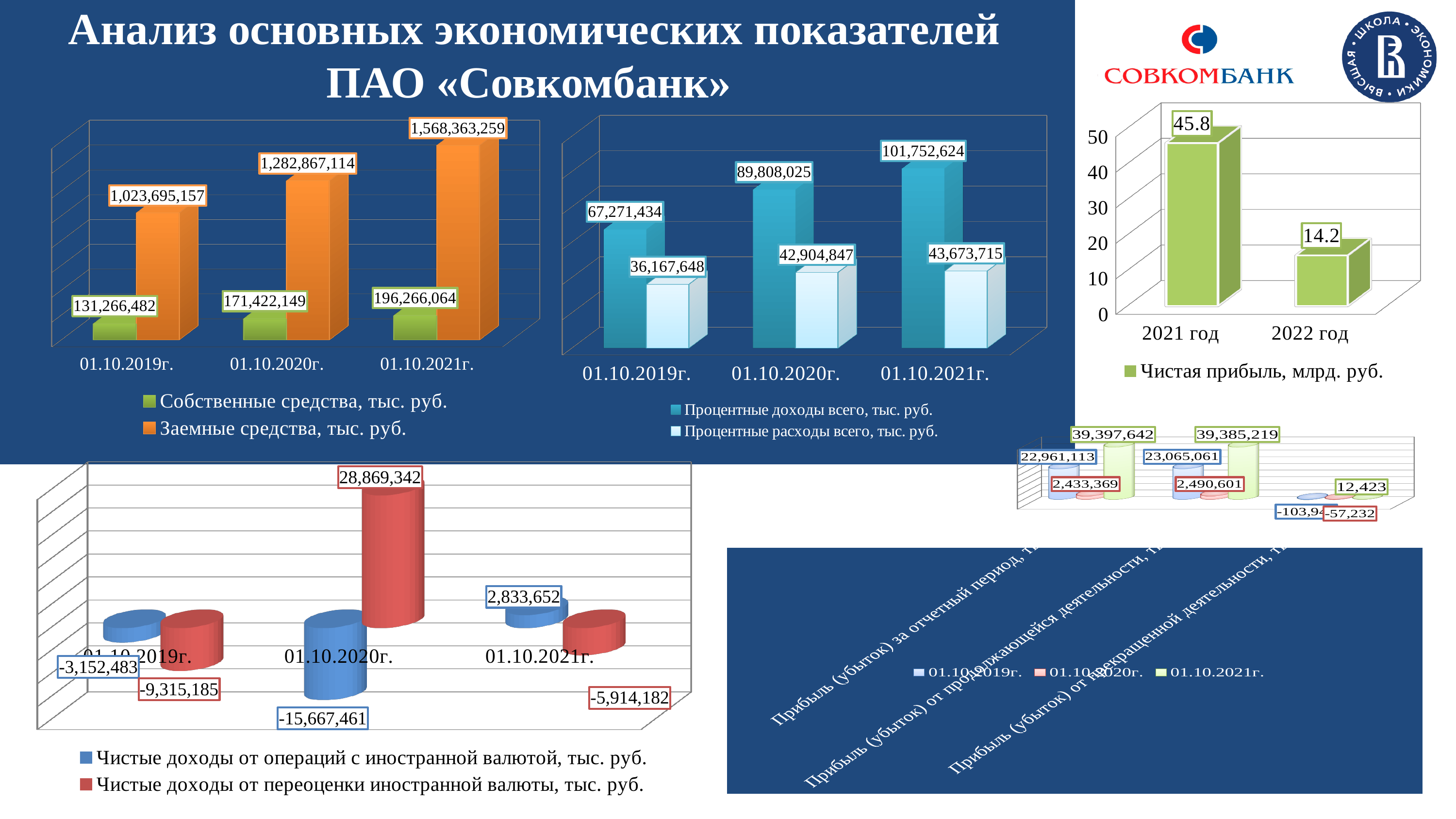
In the top-left chart (Собственные средства / Заемные средства), do the values of Собственные средства rise or fall from 01.10.2019г. to 01.10.2021г.? rise In the top-right chart (Чистая прибыль, млрд. руб.), what is the difference between 2021 год and 2022 год? 31.6 In the top-middle chart (Процентные доходы / Процентные расходы), what is the difference between Процентные доходы всего and Процентные расходы всего for 01.10.2021г.? 58,078,909 In the top-middle chart (Процентные доходы / Процентные расходы), what is the value of Процентные доходы всего, тыс. руб. for 01.10.2020г.? 89,808,025 In the bottom-left chart (Чистые доходы от операций с иностранной валютой / от переоценки иностранной валюты), what is the value of Чистые доходы от переоценки иностранной валюты, тыс. руб. for 01.10.2020г.? 28,869,342 In the top-right chart (Чистая прибыль, млрд. руб.), how many categories are shown on the x axis? 2 In the bottom-left chart (Чистые доходы от операций с иностранной валютой / от переоценки иностранной валюты), how many series does the legend list? 2 In the bottom-left chart (Чистые доходы от операций с иностранной валютой / от переоценки иностранной валюты), which date has the lowest value of Чистые доходы от операций с иностранной валютой? 01.10.2020г. In the top-right chart (Чистая прибыль, млрд. руб.), what is the value for 2022 год? 14.2 In the top-middle chart (Процентные доходы / Процентные расходы), which date has the lowest value of Процентные расходы всего? 01.10.2019г. In the top-left chart (Собственные средства / Заемные средства), what is the value of Собственные средства, тыс. руб. for 01.10.2019г.? 131,266,482 In the top-left chart (Собственные средства / Заемные средства), what is the value of Заемные средства, тыс. руб. for 01.10.2021г.? 1,568,363,259